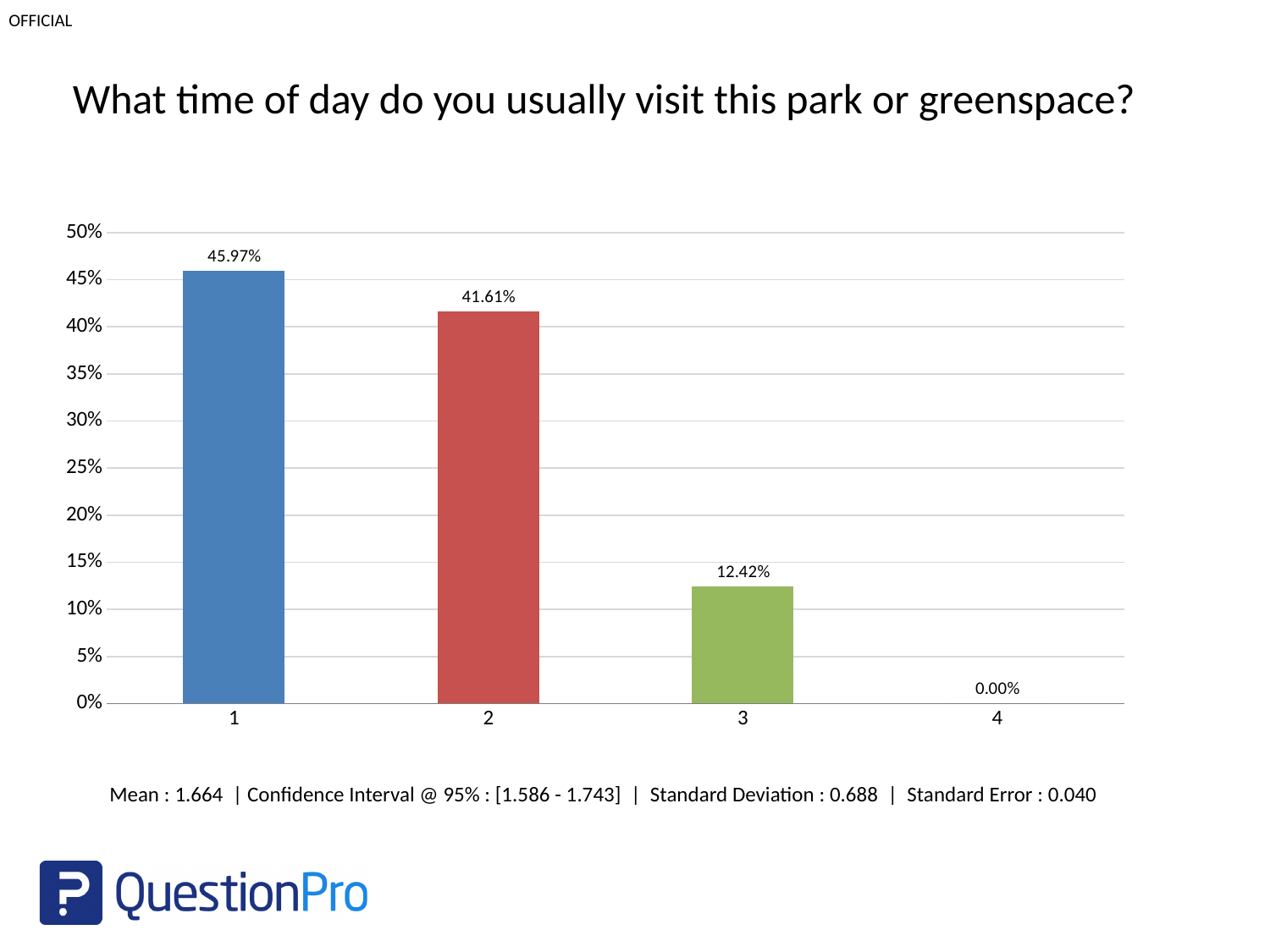
Which category has the lowest value? 4 What is the value for category 1? 45.97% Which is larger, the value for category 2 or category 3? 2 What is the difference between the values for category 1 and category 2? 4.36% Do the values rise or fall from category 1 to category 4? fall What kind of chart is shown on the slide? bar chart Is the value for category 3 greater or less than 15%? less Which category has the highest value? 1 What is the value for category 4? 0.00% What is the value for category 2? 41.61% What is the value for category 3? 12.42% How many categories are shown on the x axis? 4